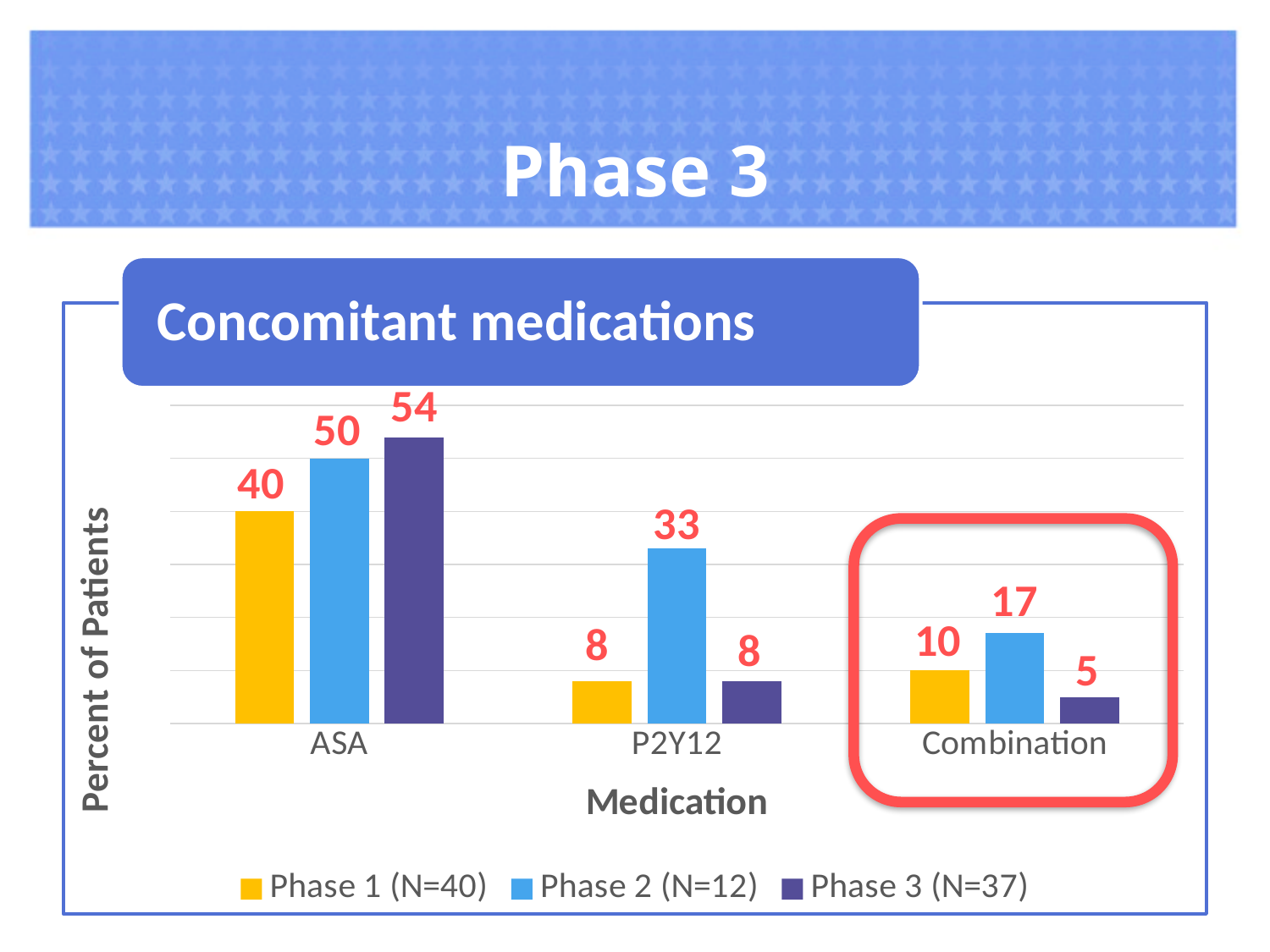
What is the value for Phase 3 (N=37) in the ASA category? 54 What kind of chart is shown on the slide? Bar chart Which medication category has the highest value for Phase 2 (N=12)? ASA Which is larger for P2Y12: the Phase 2 (N=12) value or the Phase 3 (N=37) value? Phase 2 (N=12) What is the value for Phase 2 (N=12) in the P2Y12 category? 33 What is the value for Phase 1 (N=40) in the Combination category? 10 What is the title of the chart? Concomitant medications What is the difference between the Phase 2 (N=12) and Phase 3 (N=37) values for Combination? 12 How many medication categories are shown on the x axis? 3 Which medication category has the lowest value for Phase 3 (N=37)? Combination What is the difference between the Phase 3 (N=37) and Phase 1 (N=40) values for ASA? 14 How many series does the legend list? 3